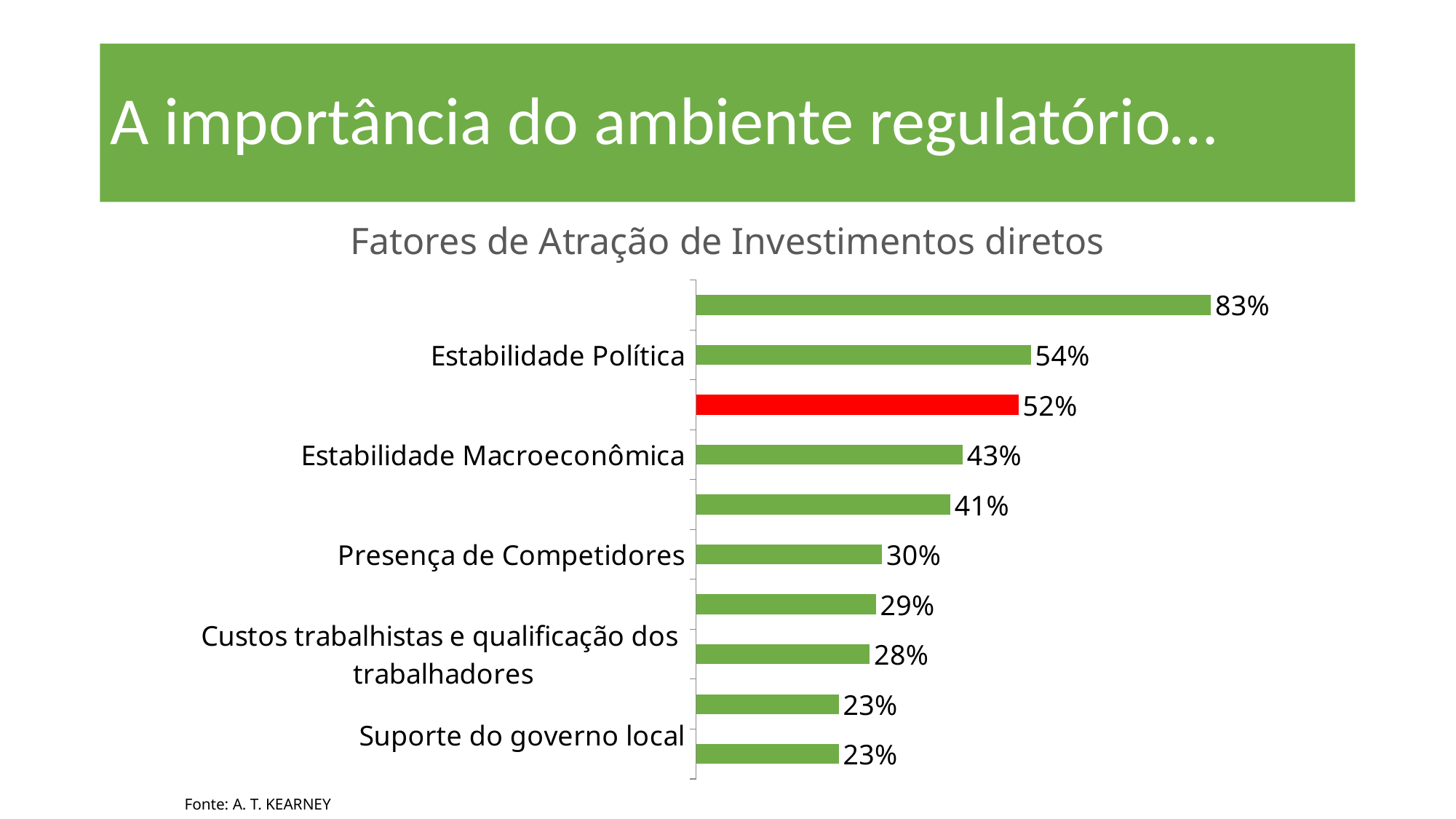
What is the lowest value shown on the chart? 23% How many bars are plotted on the chart? 10 Which is larger, the value for Presença de Competidores or the value for Suporte do governo local? Presença de Competidores What kind of chart is shown on the slide? Bar chart What is the highest value shown on the chart? 83% What is the difference between the values for Estabilidade Política and Estabilidade Macroeconômica? 11% What is the value for Estabilidade Política? 54% What is the value for Suporte do governo local? 23% What is the value for Estabilidade Macroeconômica? 43% What is the value of the bar highlighted in red? 52% What is the value for Presença de Competidores? 30% What is the value for Custos trabalhistas e qualificação dos trabalhadores? 28%